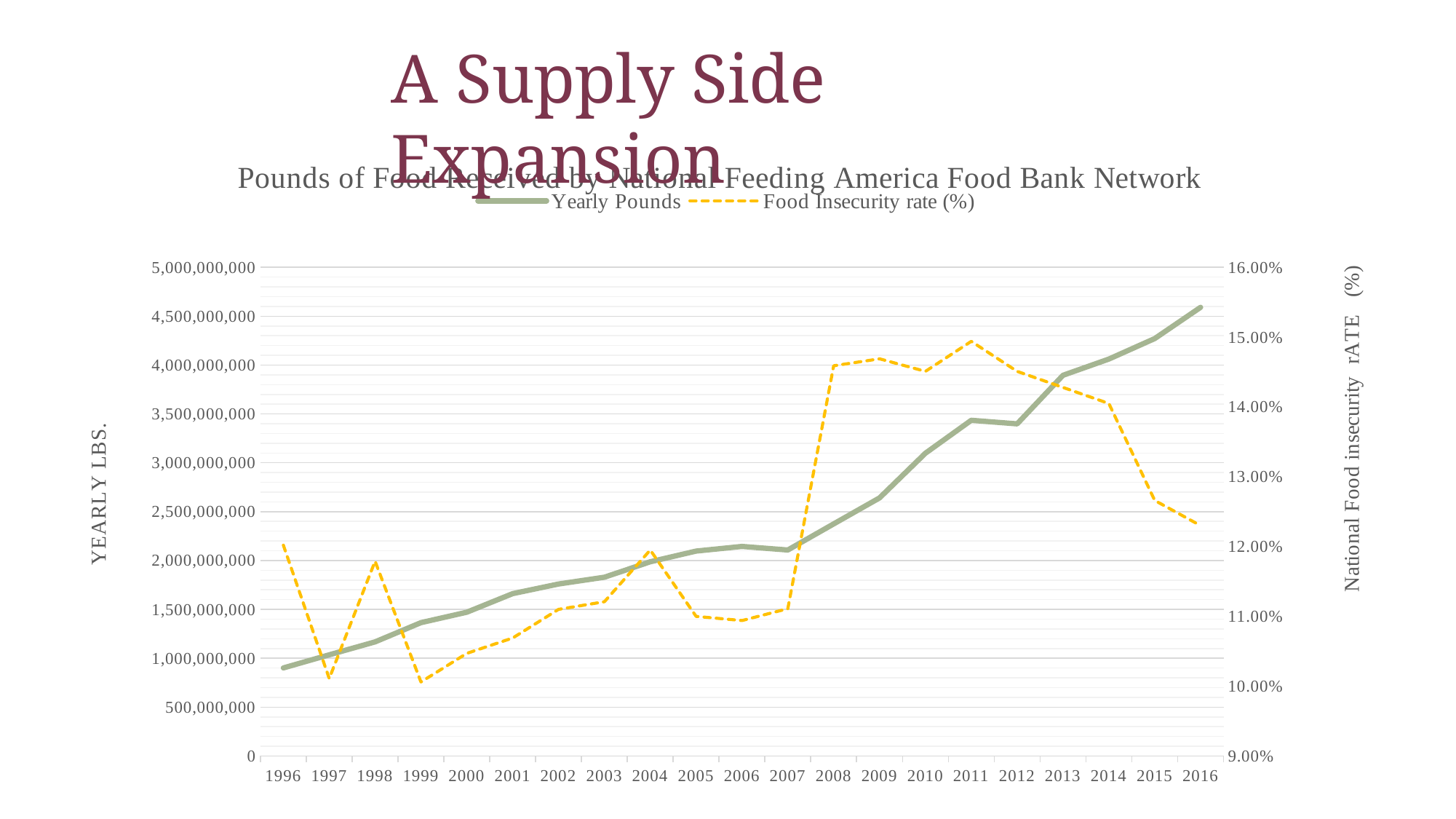
How many years are plotted along the x axis? 21 Is the Yearly Pounds value for 2009 greater or less than 3,000,000,000? less What kind of chart is shown on the slide? line chart Is the Food Insecurity rate for 2011 greater or less than 14.00%? greater How many series does the legend list? 2 In which year is the Yearly Pounds value highest? 2016 Is the Yearly Pounds value for 2016 greater or less than 4,500,000,000? greater In which year is the Yearly Pounds value lowest? 1996 In which year is the Food Insecurity rate highest? 2011 Which year has the larger Food Insecurity rate, 2007 or 2008? 2008 Do the Yearly Pounds values generally rise or fall from 1996 to 2016? rise